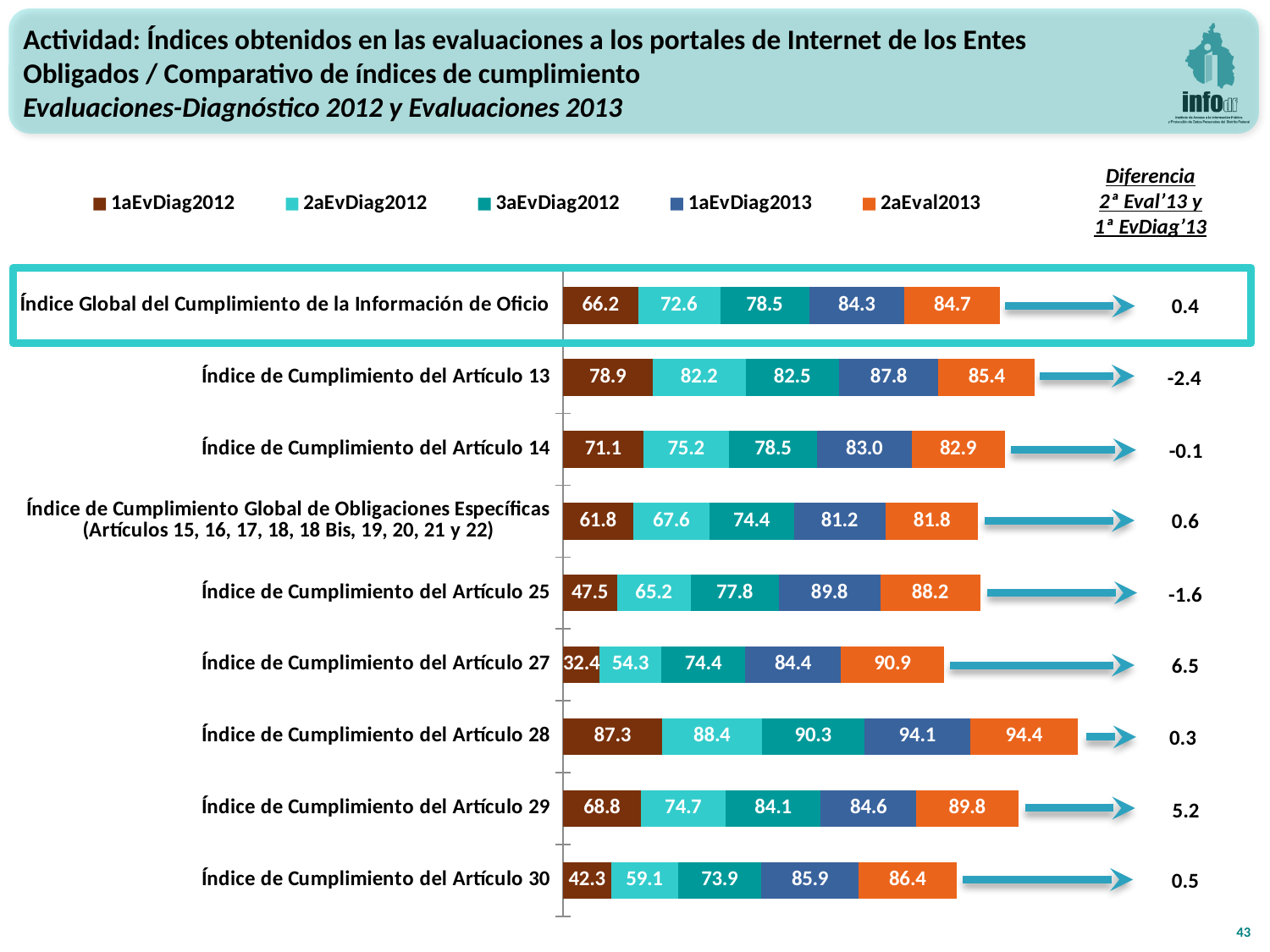
What is the 1aEvDiag2012 value for Índice de Cumplimiento del Artículo 27? 32.4 Which category has the lowest 1aEvDiag2012 value? Índice de Cumplimiento del Artículo 27 How many series does the legend list? 5 What is the difference between the 2aEval2013 and 1aEvDiag2013 values for Índice de Cumplimiento del Artículo 29? 5.2 What kind of chart is shown on the slide? Bar chart What colour represents the 2aEval2013 series in the legend? Orange What is the 1aEvDiag2013 value for Índice de Cumplimiento del Artículo 28? 94.1 What is the 2aEval2013 value for Índice de Cumplimiento del Artículo 13? 85.4 Which category has the highest 2aEval2013 value? Índice de Cumplimiento del Artículo 28 Which is larger, the 1aEvDiag2012 value for Artículo 13 or the 1aEvDiag2012 value for Artículo 14? Artículo 13 What is the difference between the 2aEval2013 and 1aEvDiag2012 values for Índice de Cumplimiento del Artículo 30? 44.1 How many categories (índices) are plotted in the chart? 9